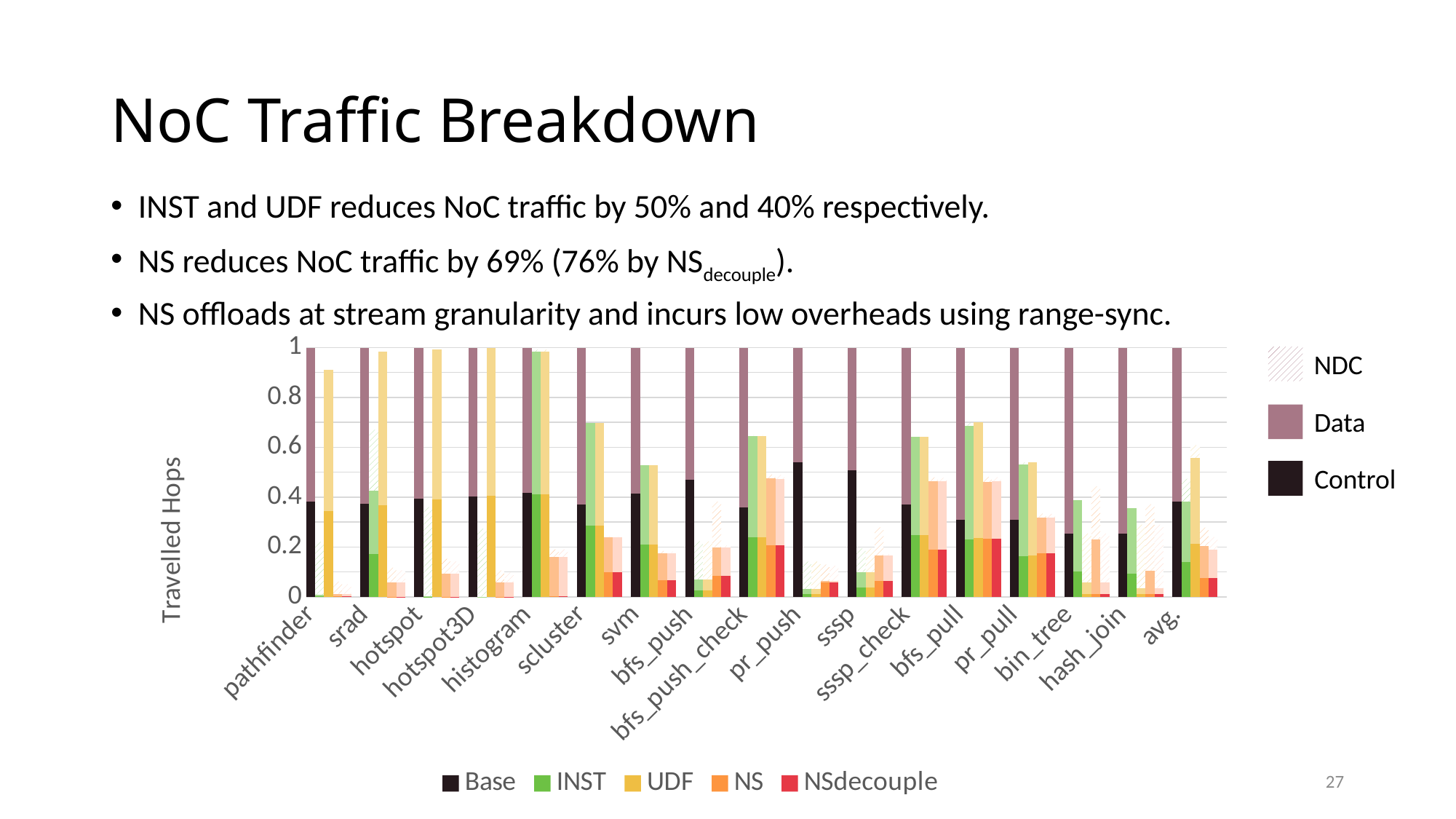
What is the label of the y axis of the chart? Travelled Hops What kind of chart is shown on the slide? bar chart For scluster, which is larger: the INST bar or the NS bar? INST Is the INST value for scluster greater or less than 0.8? less Is the UDF value for pathfinder greater or less than 0.8? greater Is the NSdecouple value for pr_push greater or less than 0.2? less How many categories (benchmarks) are shown along the x axis of the chart? 17 How many series does the legend at the bottom of the chart list? 5 What three entries does the legend on the right side of the chart list? NDC, Data, Control For pathfinder, which is larger: the UDF bar or the INST bar? UDF